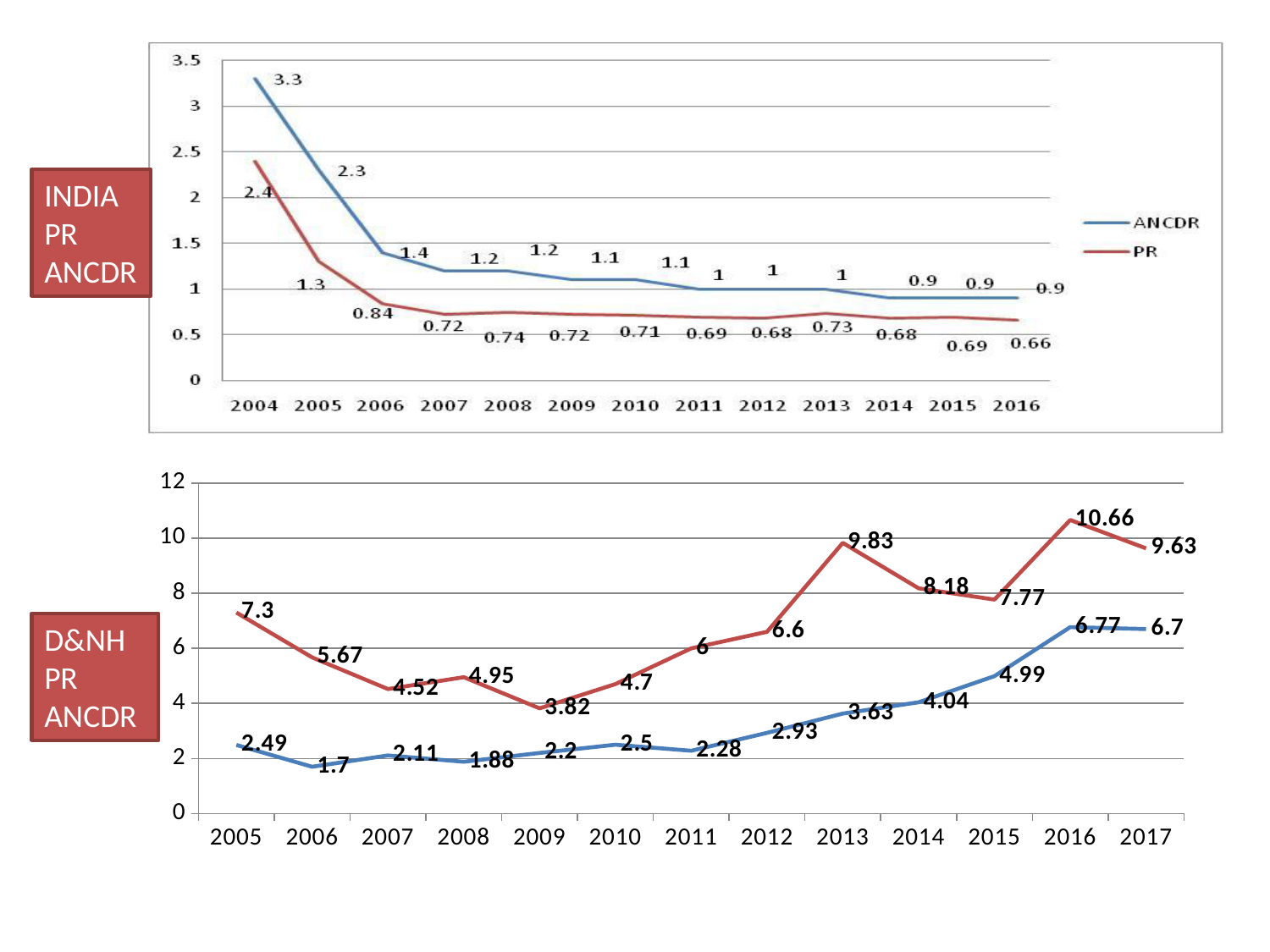
In the INDIA PR ANCDR chart, what is the ANCDR value for 2004? 3.3 What type of chart is the D&NH PR ANCDR chart? line chart In the D&NH PR ANCDR chart, in which year does the red line reach its highest value? 2016 In the INDIA PR ANCDR chart, what is the difference between the ANCDR and PR values in 2006? 0.56 In the D&NH PR ANCDR chart, what is the difference between the red and blue line values in 2017? 2.93 In the D&NH PR ANCDR chart, which is larger: the blue line value in 2016 or in 2015? 2016 In the INDIA PR ANCDR chart, does the ANCDR line generally rise or fall from 2004 to 2016? fall In the D&NH PR ANCDR chart, what is the value of the red line in 2013? 9.83 In the INDIA PR ANCDR chart, how many series does the legend list? 2 In the D&NH PR ANCDR chart, in which year is the blue line at its lowest value? 2006 In the INDIA PR ANCDR chart, what is the PR value for 2016? 0.66 In the INDIA PR ANCDR chart, how many years are shown on the x axis? 13